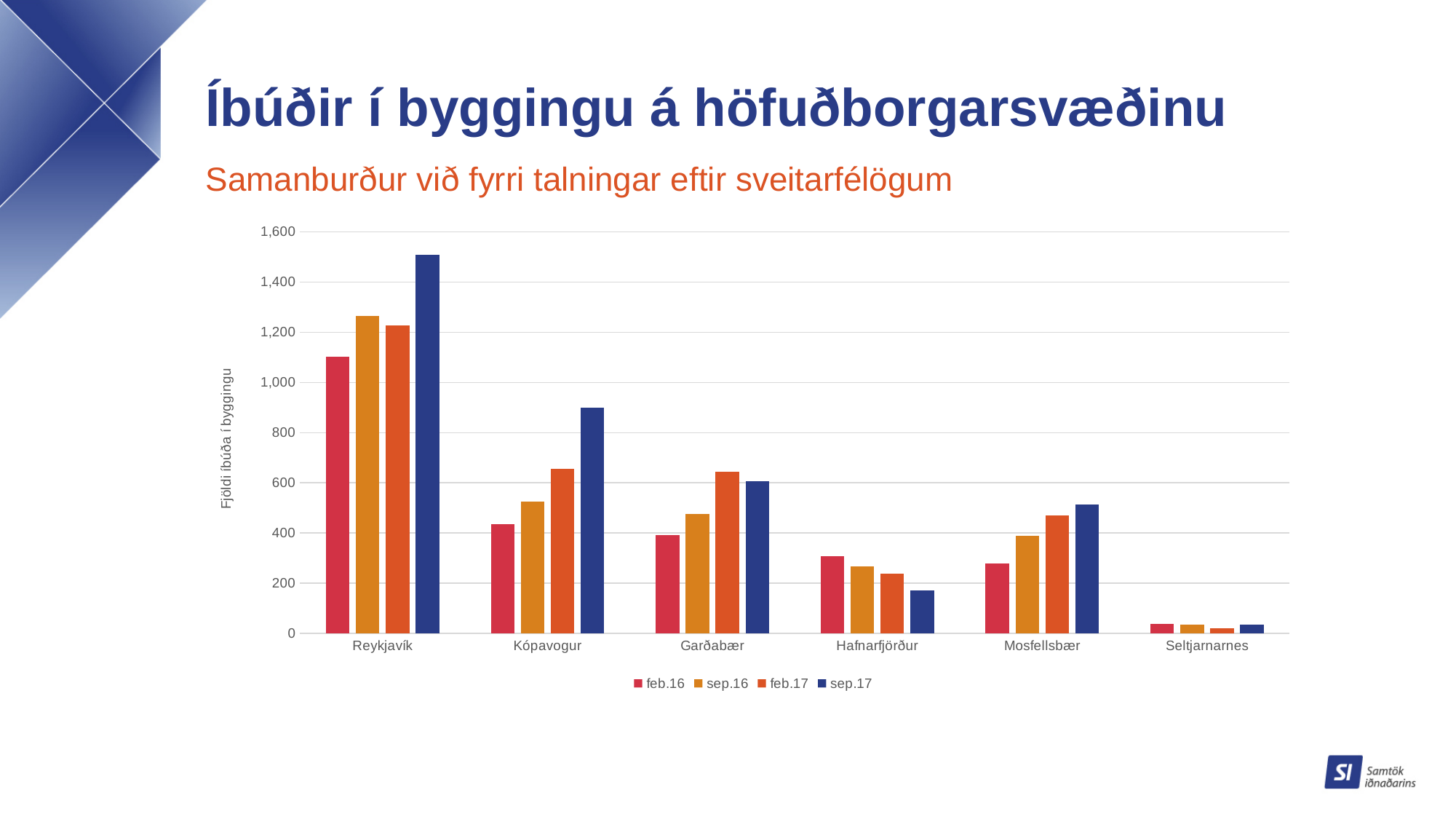
Is the sep.17 value for Reykjavík greater or less than 1,400? greater Do the values for Hafnarfjörður rise or fall from feb.16 to sep.17? fall What is the title of the y axis? Fjöldi íbúða í byggingu How many municipalities are shown on the x axis? 6 Is the sep.17 value for Hafnarfjörður greater or less than 200? less What kind of chart is shown on the slide? bar chart Which municipality has the lowest sep.17 value? Seltjarnarnes For Garðabær, which is larger: the feb.17 value or the sep.17 value? feb.17 How many series does the legend list? 4 Do the values for Mosfellsbær rise or fall from feb.16 to sep.17? rise Is the sep.17 value for Kópavogur greater or less than 800? greater Which municipality has the highest sep.17 value? Reykjavík